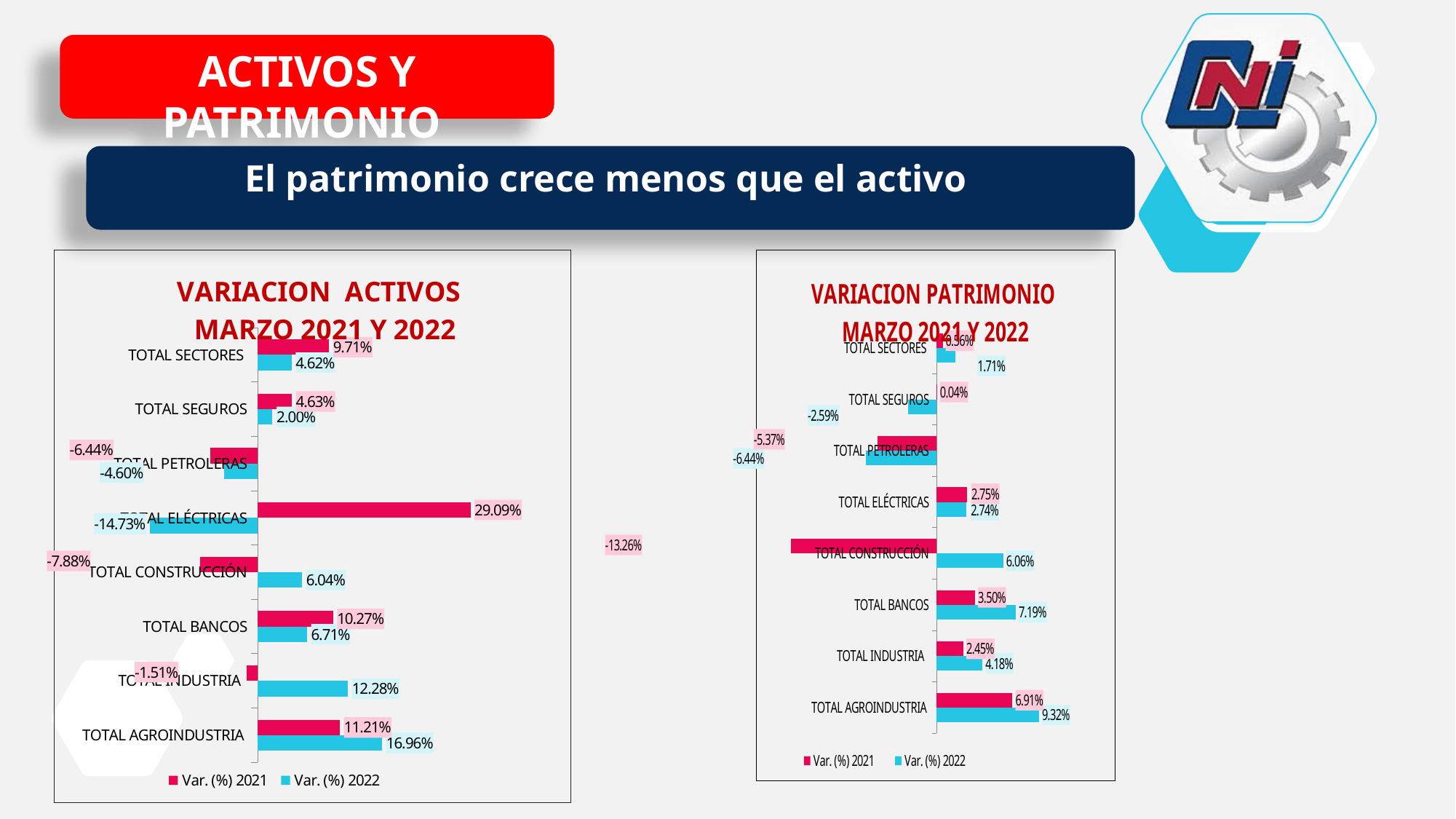
In the VARIACION ACTIVOS chart, what is the Var. (%) 2022 value for TOTAL AGROINDUSTRIA? 16.96% In the VARIACION ACTIVOS chart, which category has the lowest Var. (%) 2022 value? TOTAL ELÉCTRICAS In the VARIACION ACTIVOS chart, what is the difference between the Var. (%) 2021 and Var. (%) 2022 values for TOTAL BANCOS? 3.56% In the VARIACION PATRIMONIO chart, which category has the lowest Var. (%) 2021 value? TOTAL CONSTRUCCIÓN In the VARIACION ACTIVOS chart, which category has the highest Var. (%) 2021 value? TOTAL ELÉCTRICAS How many series does the legend of the VARIACION PATRIMONIO chart list? 2 In the VARIACION PATRIMONIO chart, what is the Var. (%) 2021 value for TOTAL CONSTRUCCIÓN? -13.26% In the VARIACION PATRIMONIO chart, what is the Var. (%) 2022 value for TOTAL BANCOS? 7.19% In the VARIACION ACTIVOS chart, what is the Var. (%) 2021 value for TOTAL ELÉCTRICAS? 29.09% In the VARIACION ACTIVOS chart, how many categories are shown? 8 In the VARIACION PATRIMONIO chart, which is larger for TOTAL AGROINDUSTRIA: the Var. (%) 2021 value or the Var. (%) 2022 value? Var. (%) 2022 What type of chart is the VARIACION ACTIVOS chart? Bar chart